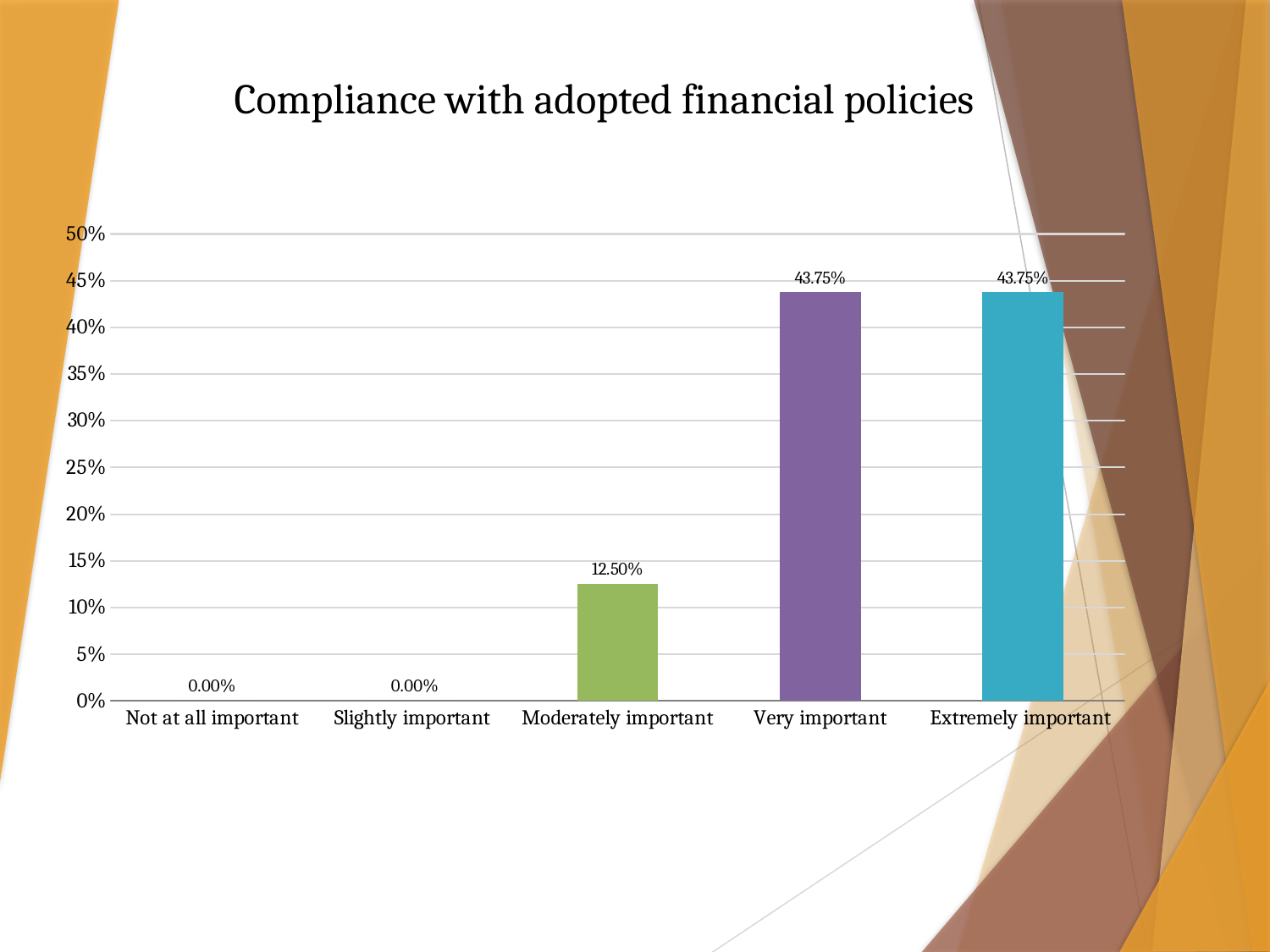
Is the value for Very important greater or less than 40%? greater What is the title of the chart? Compliance with adopted financial policies What is the value for Not at all important? 0.00% Is the value for Moderately important greater or less than 15%? less How many categories are shown on the x axis? 5 What is the difference between the values for Very important and Moderately important? 31.25% What is the value for Moderately important? 12.50% Which is larger, the value for Moderately important or the value for Extremely important? Extremely important What is the value for Extremely important? 43.75% What is the value for Slightly important? 0.00% What kind of chart is shown on the slide? bar chart What is the value for Very important? 43.75%